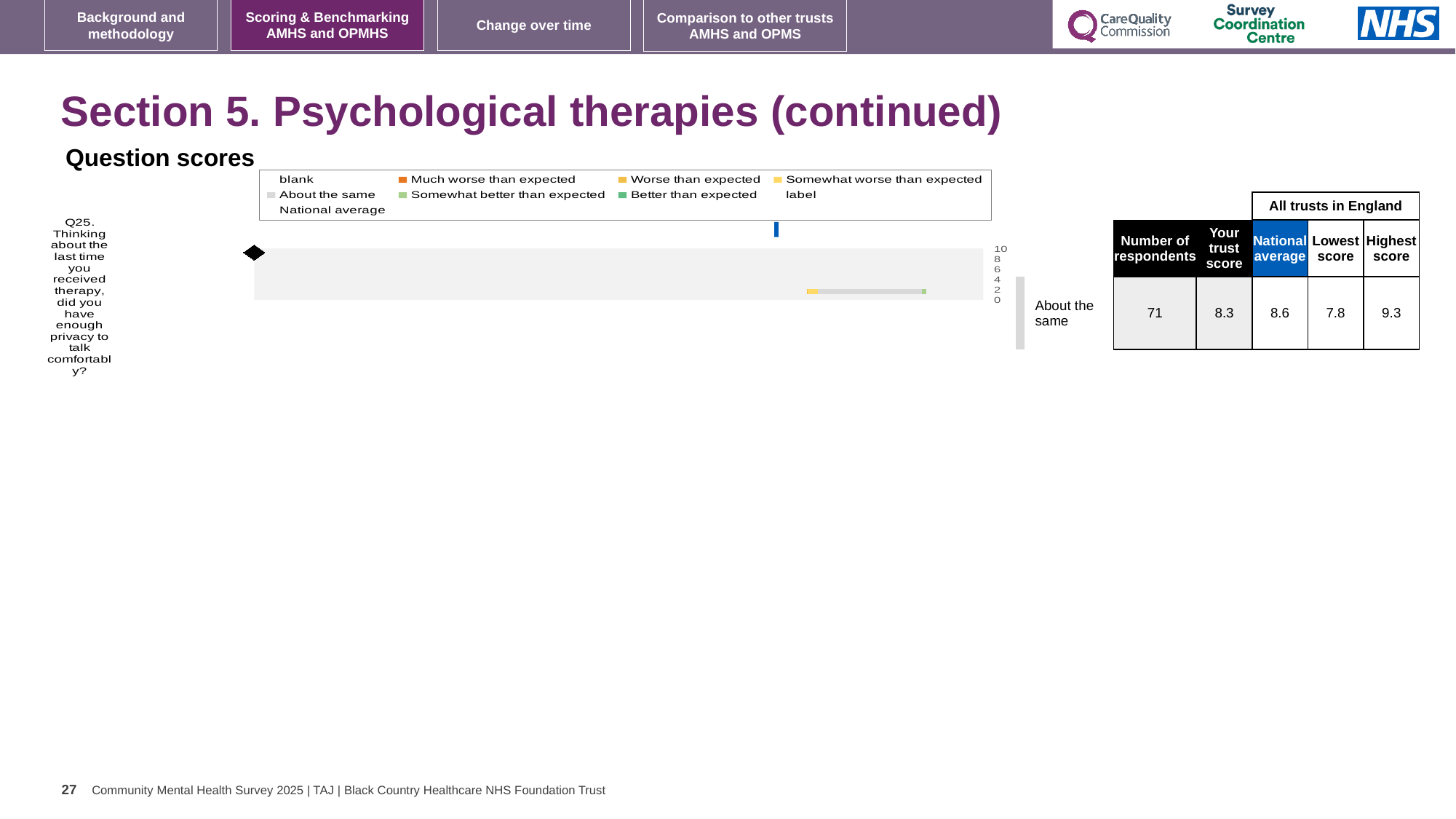
What is the difference between the highest score and the lowest score for Q25 in the table? 1.5 What is the highest value shown on the score axis of the Question scores chart? 10 In the table beside the chart, what is the highest score among all trusts in England for Q25? 9.3 In the table beside the chart, what is the national average for Q25? 8.6 What benchmark category label is shown next to the bar for Q25? About the same What kind of chart is shown under 'Question scores'? bar chart Is the trust score for Q25 larger or smaller than the national average? smaller How many survey questions are plotted in the Question scores chart? 1 In the table beside the chart, how many respondents answered Q25? 71 In the table beside the chart, what is the lowest score among all trusts in England for Q25? 7.8 Which question is plotted in the Question scores chart? Q25. Thinking about the last time you received therapy, did you have enough privacy to talk comfortably? In the table beside the chart, what is the trust score for Q25? 8.3